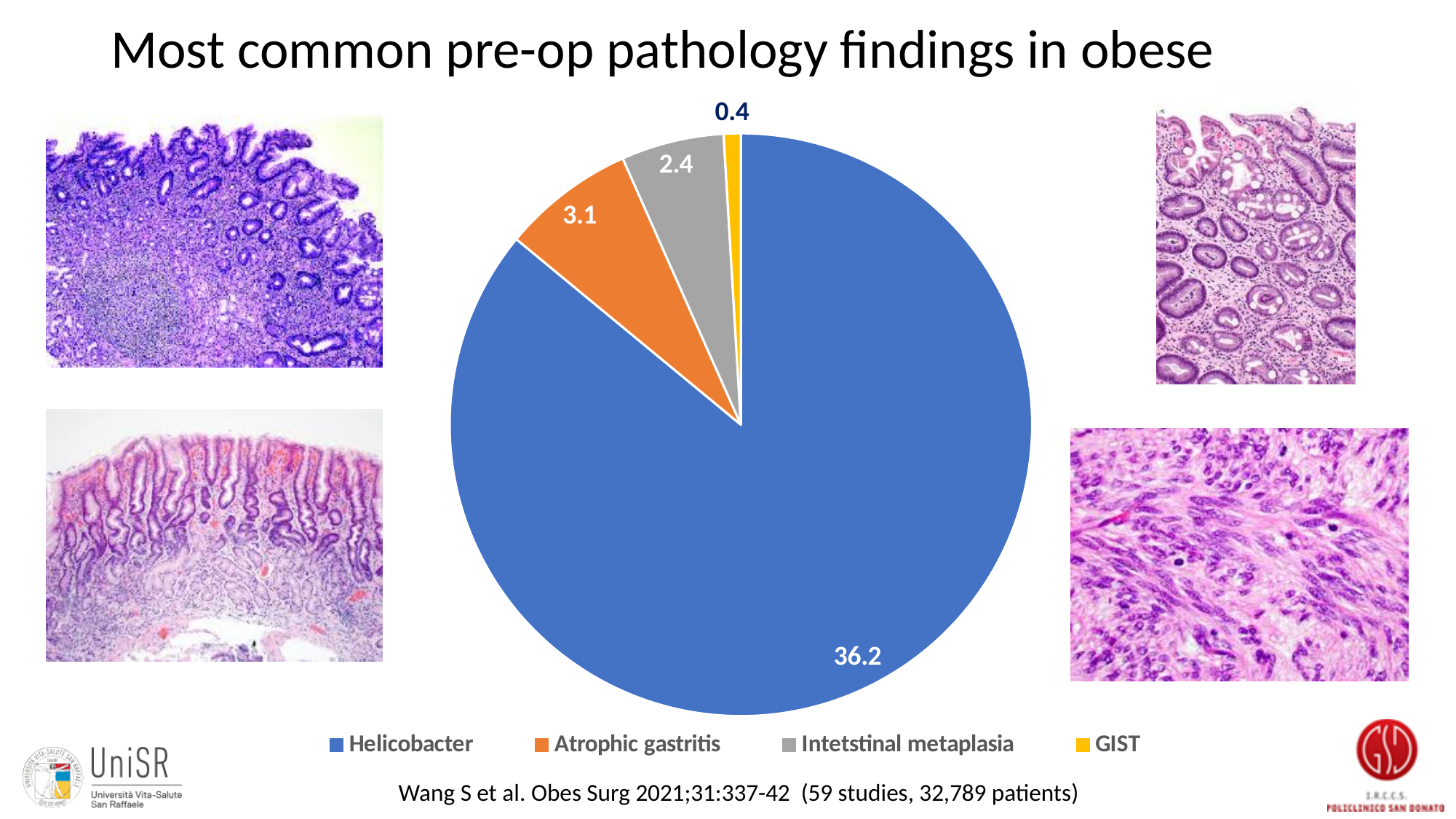
What is the difference between the values for Atrophic gastritis and Intetstinal metaplasia? 0.7 What colour is the slice for Intetstinal metaplasia? Grey What is the value for Helicobacter in the pie chart? 36.2 Which category has the smallest slice in the pie chart? GIST What is the value for GIST in the pie chart? 0.4 Which category has the largest slice in the pie chart? Helicobacter What is the value for Intetstinal metaplasia in the pie chart? 2.4 Which is larger, the value for Atrophic gastritis or the value for GIST? Atrophic gastritis How many categories does the pie chart show? 4 What is the value for Atrophic gastritis in the pie chart? 3.1 What is the difference between the values for Helicobacter and Atrophic gastritis? 33.1 What kind of chart is shown on the slide? Pie chart